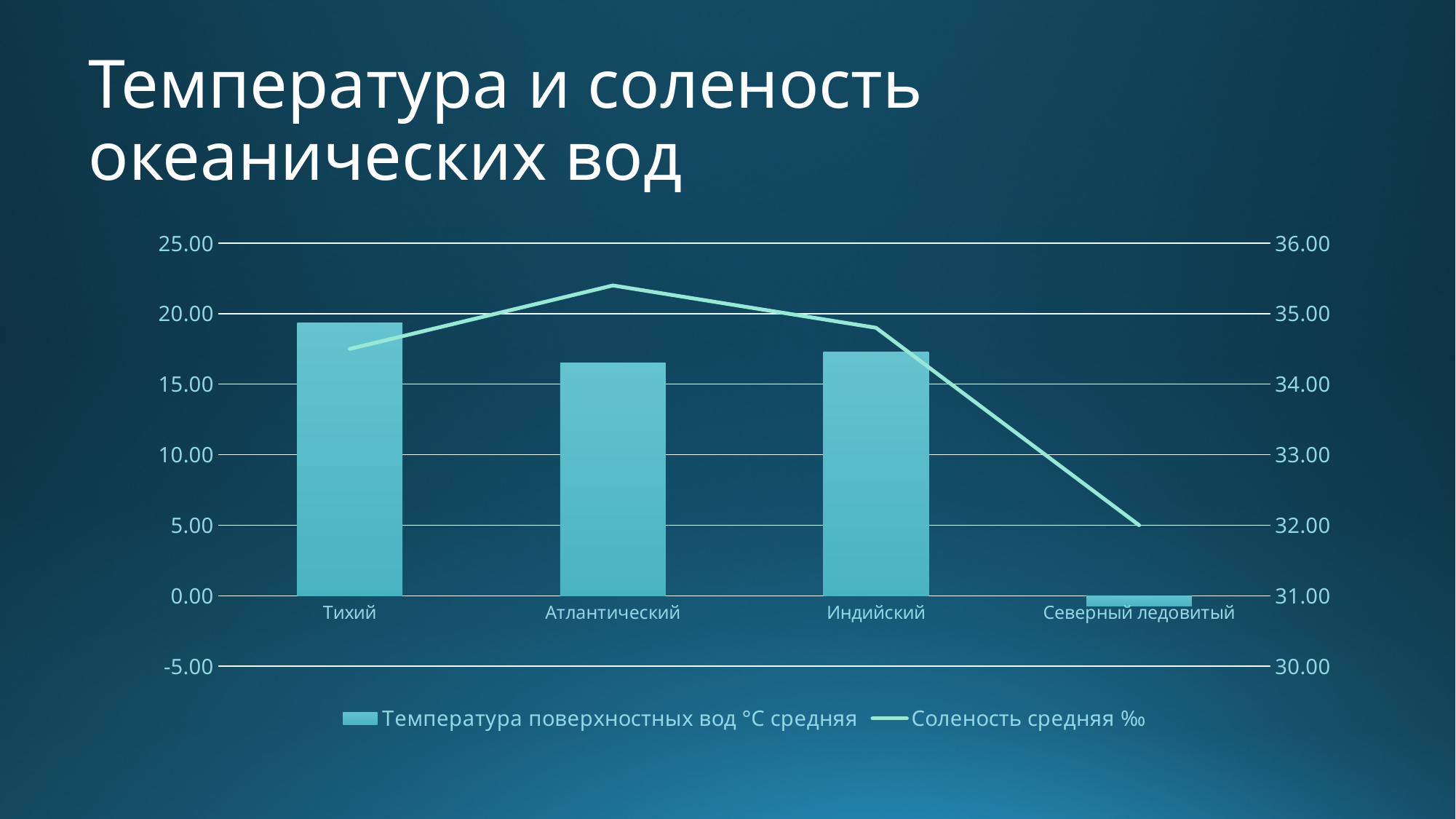
Which ocean has the highest average salinity on the line series? Атлантический How many oceans (categories) are shown on the x axis? 4 What kind of chart is shown on the slide? A combination bar and line chart Which ocean has the highest average surface water temperature (bar)? Тихий Which ocean has the lowest average surface water temperature (bar)? Северный ледовитый Does the salinity line rise or fall from Индийский to Северный ледовитый? fall Is the temperature bar for Тихий greater or less than 15.00? greater Which has the higher average surface water temperature bar: Индийский or Атлантический? Индийский Which ocean has the lowest average salinity on the line series? Северный ледовитый Is the average salinity for Северный ледовитый greater or less than 33.00? less Is the average salinity (line) for Атлантический greater or less than 35.00? greater How many series does the legend list? 2